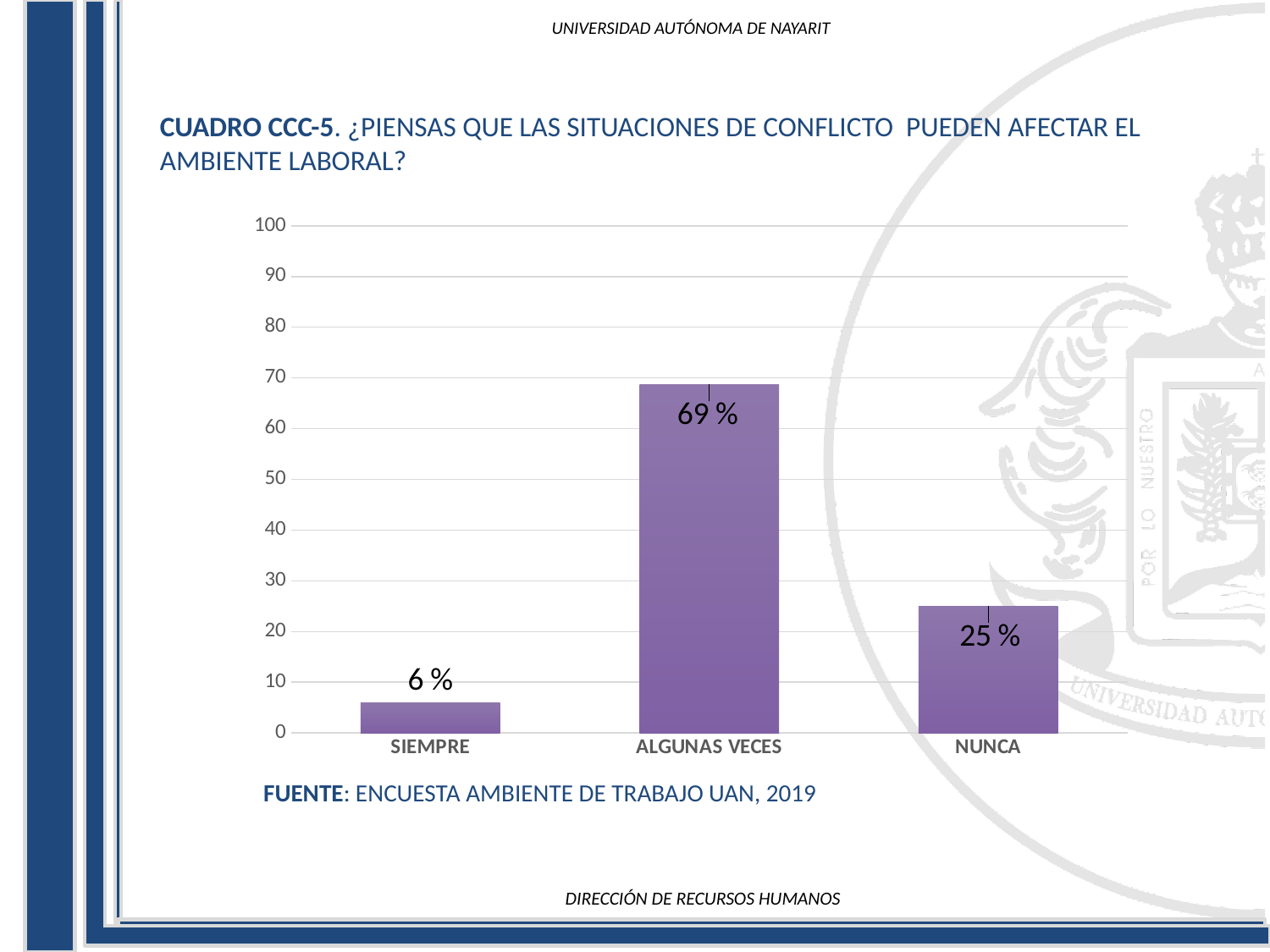
What is the difference between the values for NUNCA and SIEMPRE? 19 % What is the value for NUNCA? 25 % What kind of chart is shown on the slide? bar chart Is the value for ALGUNAS VECES greater or less than 60? greater How many categories are shown on the x axis? 3 Which category has the lowest value? SIEMPRE Which is larger, the value for NUNCA or the value for SIEMPRE? NUNCA What is the value for SIEMPRE? 6 % What is the value for ALGUNAS VECES? 69 % What is the source cited below the chart? ENCUESTA AMBIENTE DE TRABAJO UAN, 2019 What is the difference between the values for ALGUNAS VECES and NUNCA? 44 % Which category has the highest value? ALGUNAS VECES